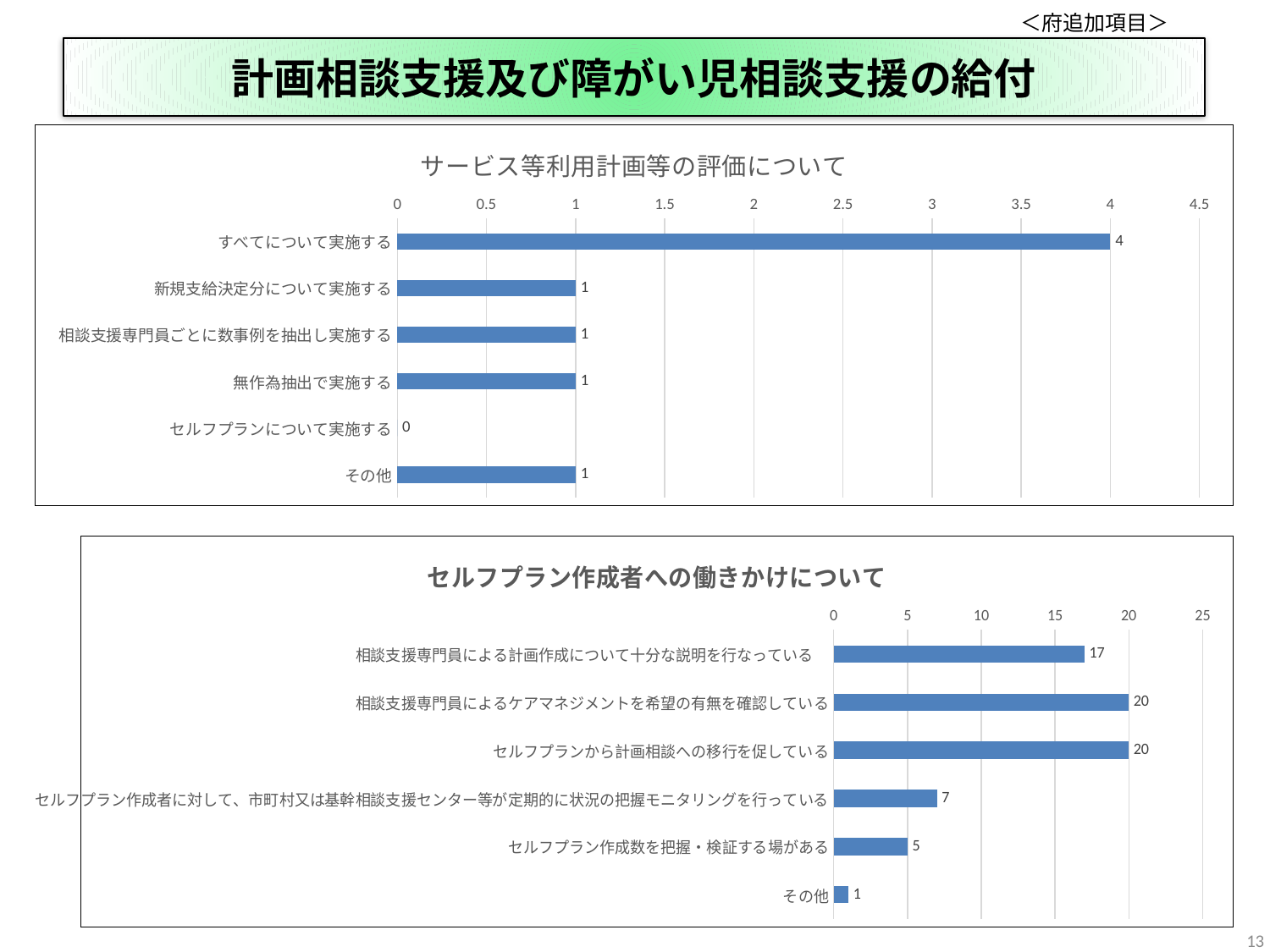
In the chart titled セルフプラン作成者への働きかけについて, which category has the lowest value? その他 What kind of chart is the chart titled サービス等利用計画等の評価について? Bar chart In the chart titled サービス等利用計画等の評価について, which category has the lowest value? セルフプランについて実施する In the chart titled セルフプラン作成者への働きかけについて, what is the value for セルフプラン作成数を把握・検証する場がある? 5 In the chart titled セルフプラン作成者への働きかけについて, what is the value for 相談支援専門員による計画作成について十分な説明を行なっている? 17 In the chart titled セルフプラン作成者への働きかけについて, which is larger: the value for 相談支援専門員による計画作成について十分な説明を行なっている or the value for セルフプランから計画相談への移行を促している? セルフプランから計画相談への移行を促している In the chart titled セルフプラン作成者への働きかけについて, how many categories are shown? 6 In the chart titled サービス等利用計画等の評価について, which category has the highest value? すべてについて実施する In the chart titled サービス等利用計画等の評価について, what is the difference between the values for すべてについて実施する and 無作為抽出で実施する? 3 In the chart titled サービス等利用計画等の評価について, what is the value for すべてについて実施する? 4 In the chart titled サービス等利用計画等の評価について, how many categories are shown? 6 In the chart titled セルフプラン作成者への働きかけについて, what is the difference between the values for 相談支援専門員によるケアマネジメントを希望の有無を確認している and セルフプラン作成者に対して、市町村又は基幹相談支援センター等が定期的に状況の把握モニタリングを行っている? 13